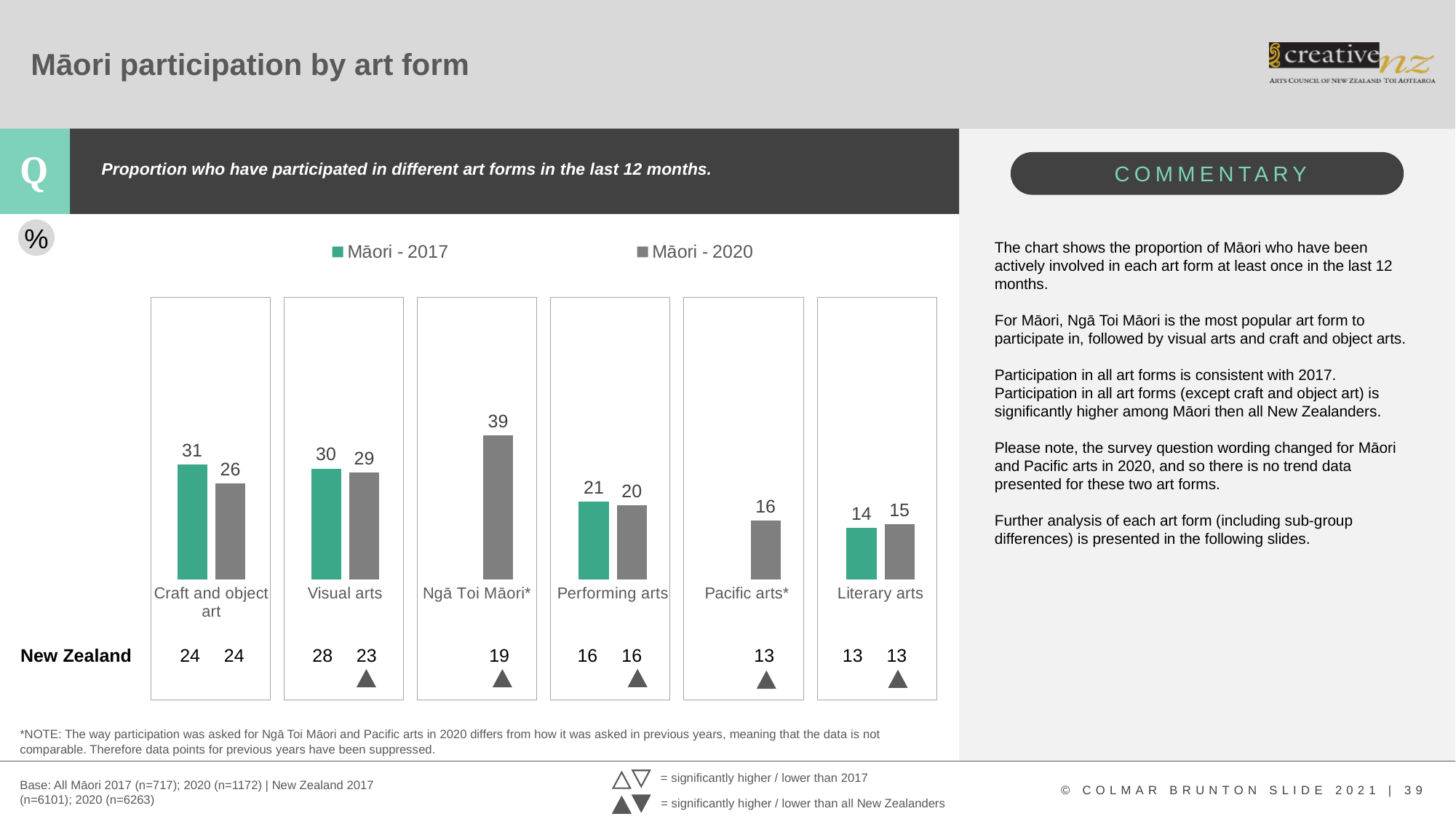
What is the Māori - 2017 value for Craft and object art? 31 Which art form has the highest Māori - 2020 value? Ngā Toi Māori* What is the Māori - 2020 value for Literary arts? 15 Which art form has the lowest Māori - 2017 value? Literary arts Which is larger for Visual arts: the Māori - 2017 value or the Māori - 2020 value? Māori - 2017 How many art form categories are shown on the chart? 6 What is the Māori - 2020 value for Ngā Toi Māori*? 39 What kind of chart is shown on the slide? Bar chart How many series does the legend list? 2 What is the Māori - 2017 value for Performing arts? 21 Which colour represents the Māori - 2017 series? Green What is the difference between the Māori - 2017 and Māori - 2020 values for Craft and object art? 5